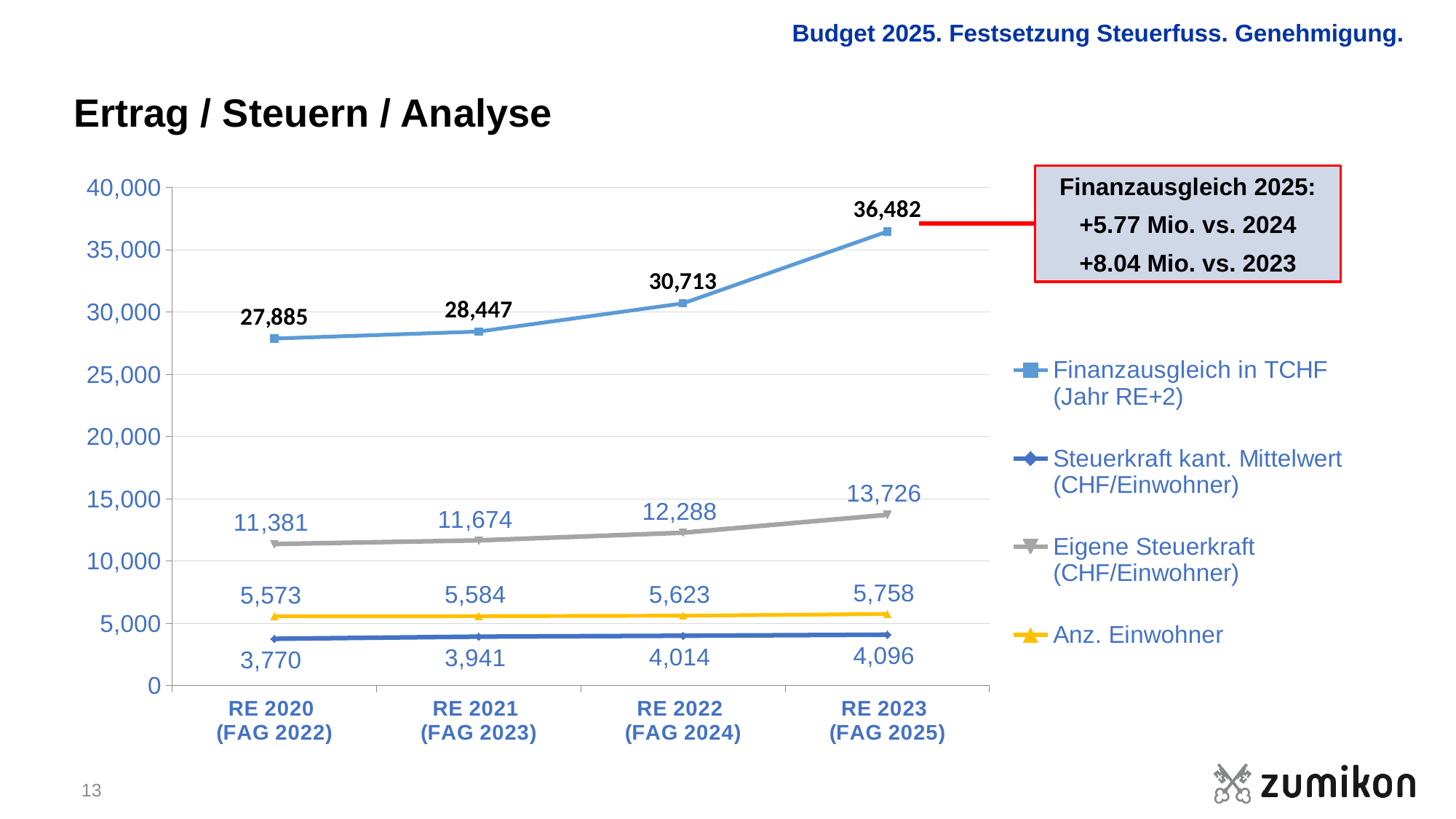
What type of chart is shown on the slide? line chart Which series is drawn in yellow? Anz. Einwohner Does Eigene Steuerkraft (CHF/Einwohner) rise or fall from RE 2020 to RE 2023? rise How many categories are shown on the x axis? 4 How many series does the legend list? 4 In which category is Finanzausgleich in TCHF lowest? RE 2020 (FAG 2022) What is the value of Eigene Steuerkraft (CHF/Einwohner) for RE 2021 (FAG 2023)? 11,674 Which is larger for RE 2023 (FAG 2025): Eigene Steuerkraft or Steuerkraft kant. Mittelwert? Eigene Steuerkraft What is the value of Steuerkraft kant. Mittelwert (CHF/Einwohner) for RE 2020 (FAG 2022)? 3,770 What is the value of Anz. Einwohner for RE 2022 (FAG 2024)? 5,623 What is the difference between Finanzausgleich in TCHF for RE 2023 (FAG 2025) and RE 2022 (FAG 2024)? 5,769 What is the value of Finanzausgleich in TCHF for RE 2023 (FAG 2025)? 36,482